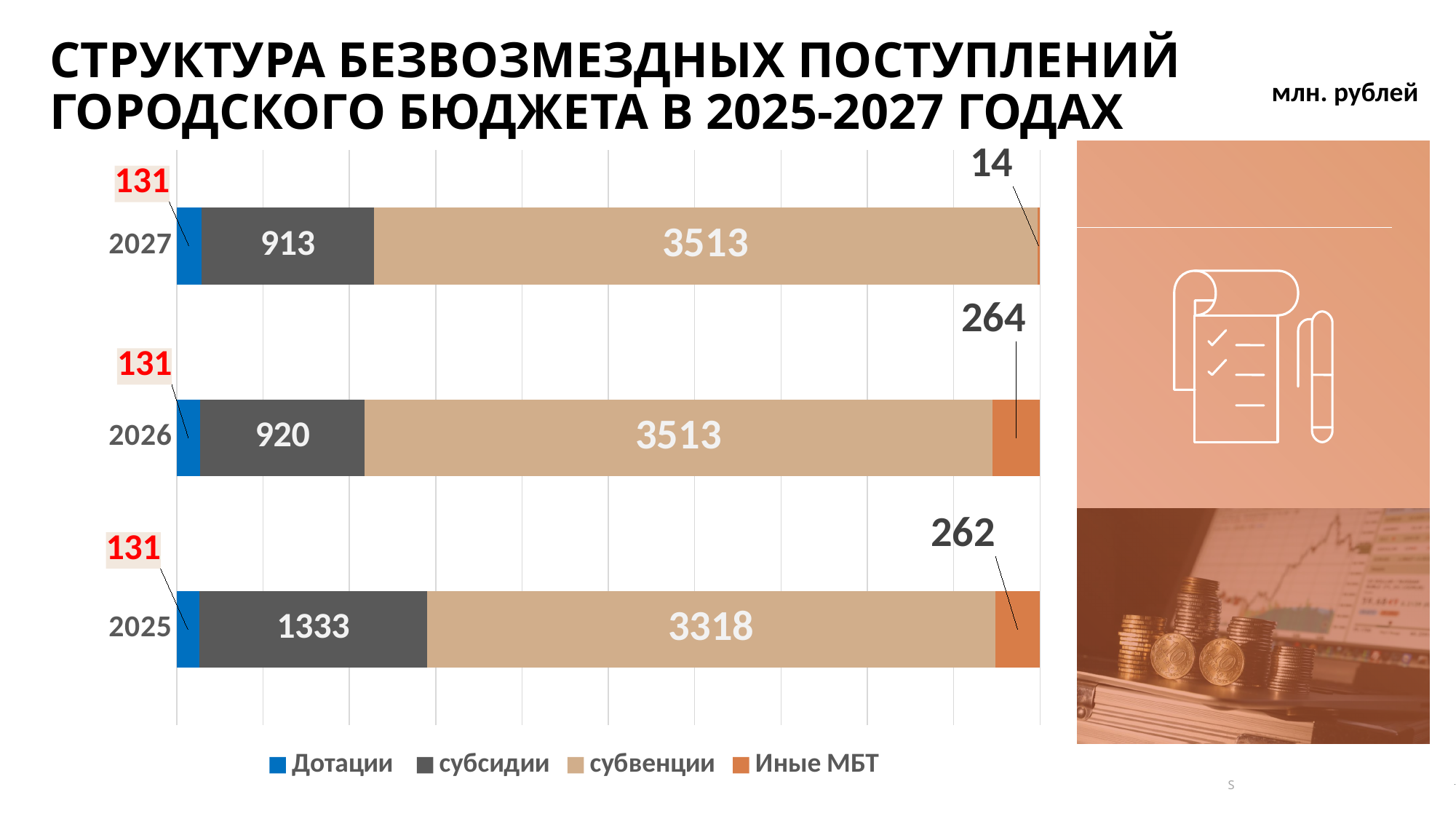
What is the value of субсидии for 2025? 1333 What kind of chart is shown on the slide? Stacked bar chart How many series does the legend list? 4 What is the total of the stacked bar for 2027? 4571 Which year has the lowest value for Иные МБТ? 2027 What is the difference between субсидии in 2025 and субсидии in 2026? 413 Which year has the highest value for субсидии? 2025 How many years (categories) are shown on the chart? 3 Which is larger: субвенции in 2025 or субвенции in 2027? субвенции in 2027 What is the value of субвенции for 2026? 3513 What is the value of Иные МБТ for 2027? 14 What is the value of Дотации for 2026? 131